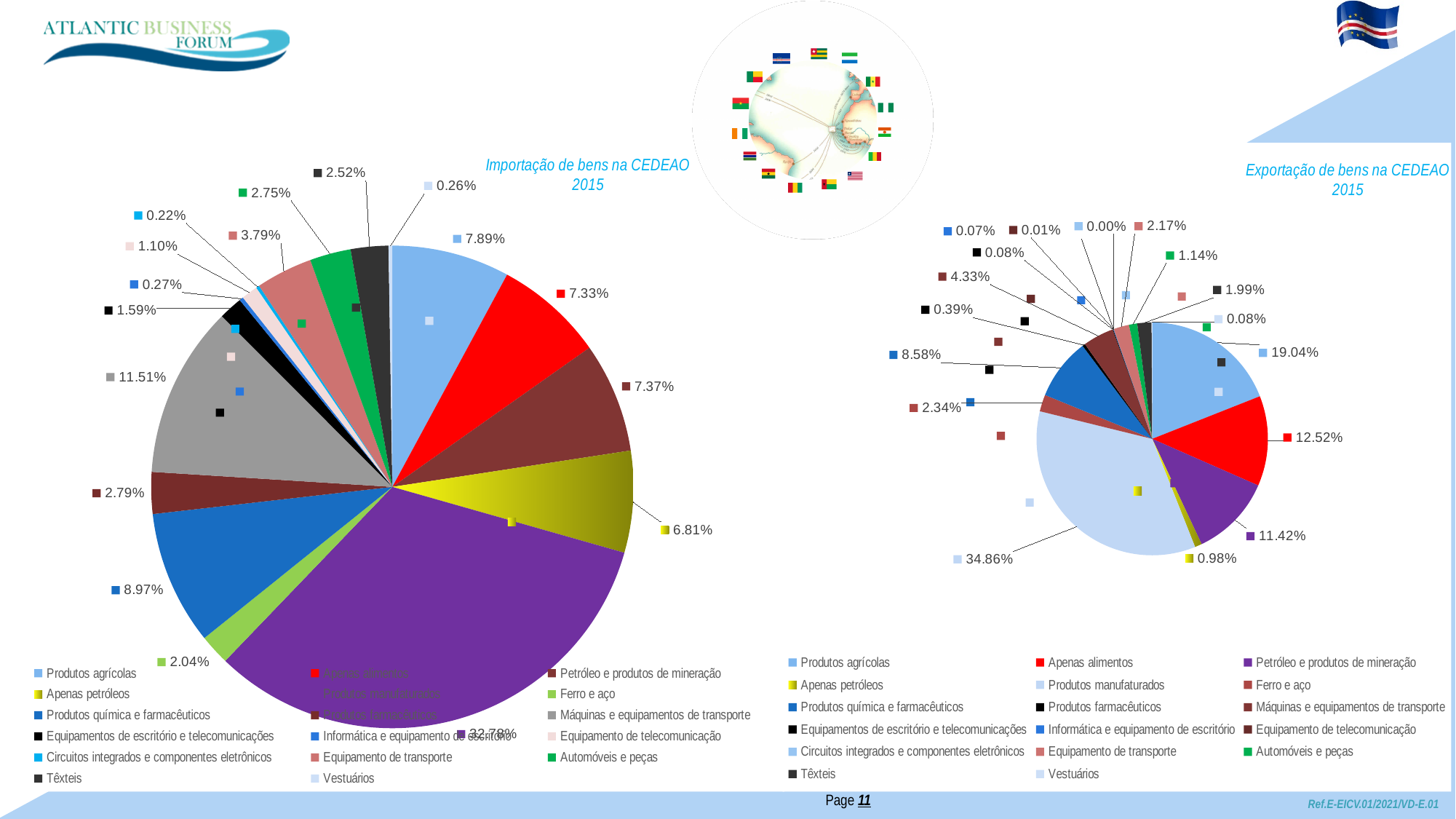
In the 'Importação de bens na CEDEAO 2015' chart, what is the share for Produtos agrícolas? 7.89% In the 'Importação de bens na CEDEAO 2015' chart, what is the share for Máquinas e equipamentos de transporte? 11.51% In the 'Importação de bens na CEDEAO 2015' chart, which category has the largest share? Produtos manufaturados In the 'Exportação de bens na CEDEAO 2015' chart, what is the share of the largest slice? 34.86% In the 'Exportação de bens na CEDEAO 2015' chart, what is the share for Apenas alimentos? 12.52% In the 'Importação de bens na CEDEAO 2015' chart, what is the share of the largest slice? 32.78% How many categories does the legend of the 'Exportação de bens na CEDEAO 2015' chart list? 17 What kind of chart is used for 'Importação de bens na CEDEAO 2015'? Pie chart In the 'Exportação de bens na CEDEAO 2015' chart, what is the share for Produtos agrícolas? 19.04% Which is larger: the Produtos manufaturados share in the 'Importação de bens na CEDEAO 2015' chart or in the 'Exportação de bens na CEDEAO 2015' chart? Exportação de bens na CEDEAO 2015 In the 'Exportação de bens na CEDEAO 2015' chart, what is the difference between the Produtos agrícolas share and the Apenas alimentos share? 6.52%